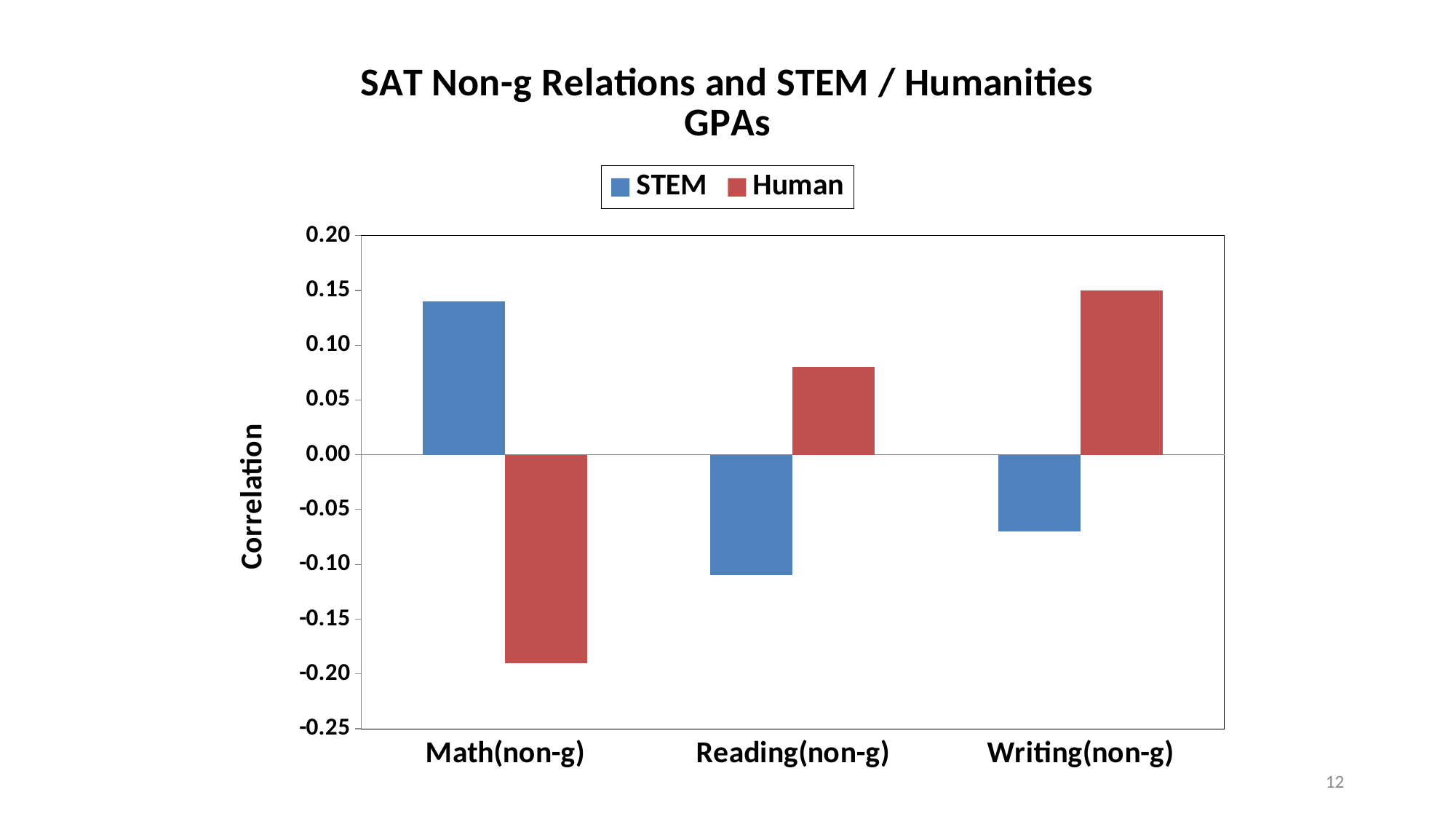
What kind of chart is shown on the slide? bar chart Is the Human value for Math(non-g) greater or less than -0.15? less Which category has the highest STEM value? Math(non-g) Which category has the highest Human value? Writing(non-g) What is the title of the vertical axis? Correlation Which category has the lowest STEM value? Reading(non-g) Is the STEM value for Writing(non-g) greater or less than -0.10? greater How many series does the legend list? 2 Which is larger, the Human value for Reading(non-g) or the Human value for Writing(non-g)? Writing(non-g) Which category has the lowest Human value? Math(non-g) How many categories are shown on the x axis? 3 Is the STEM value for Math(non-g) greater or less than 0.10? greater